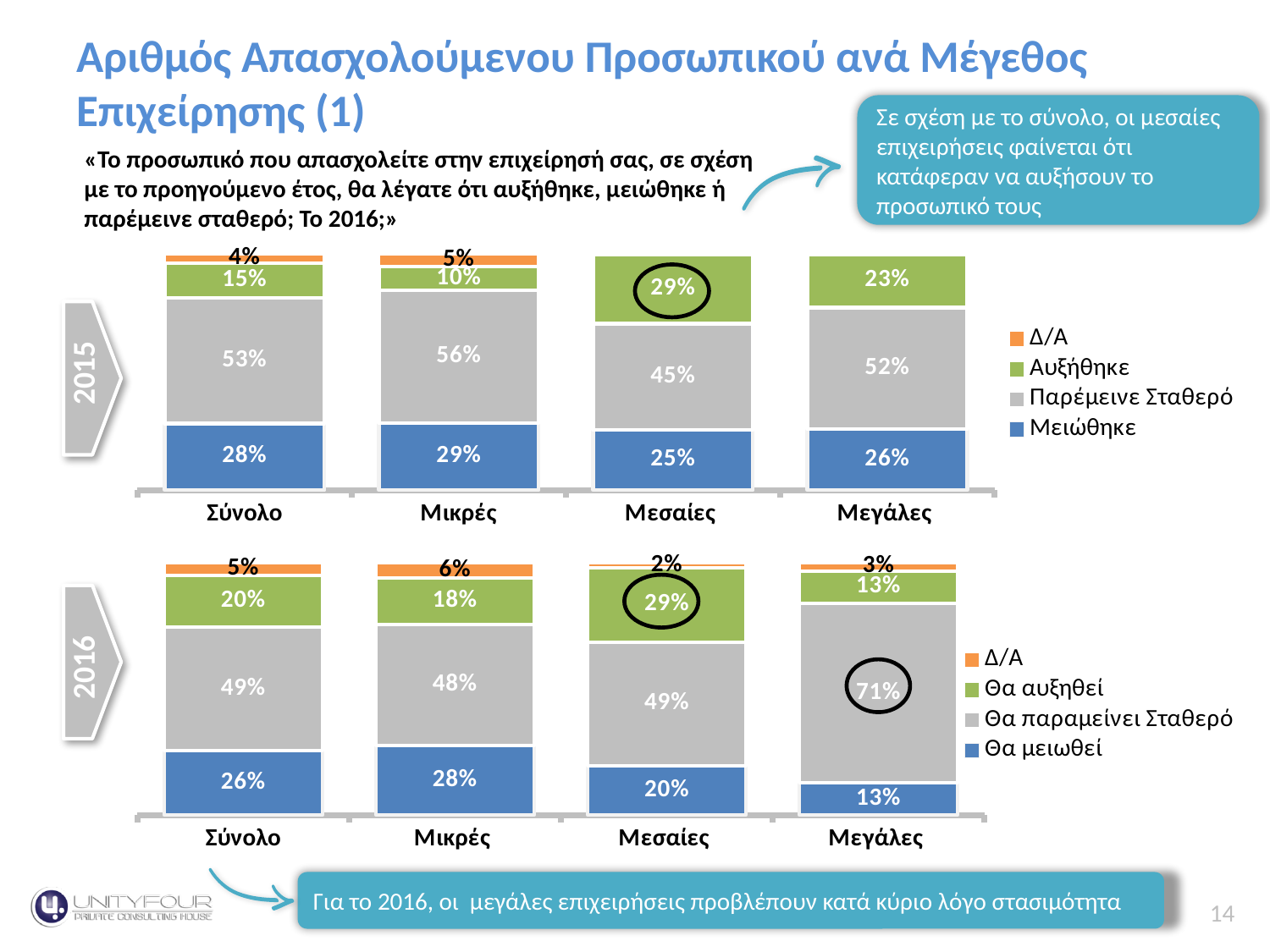
In the 2016 chart (bottom), which category has the lowest Θα αυξηθεί value? Μεγάλες In the 2015 chart (top), what is the difference between the Παρέμεινε Σταθερό values for Μικρές and Μεσαίες? 11% In the 2015 chart (top), what is the Παρέμεινε Σταθερό value for Μικρές? 56% What type of chart is the 2015 chart (top)? Stacked bar chart In the 2016 chart (bottom), what is the Θα παραμείνει Σταθερό value for Μεγάλες? 71% In the 2016 chart (bottom), which is larger: the Θα αυξηθεί value for Σύνολο or for Μικρές? Σύνολο How many series does the legend of the 2015 chart (top) list? 4 In the 2015 chart (top), what percentage of Μεσαίες businesses answered Αυξήθηκε? 29% In the 2016 chart (bottom), what is the total of the Δ/Α, Θα αυξηθεί, Θα παραμείνει Σταθερό and Θα μειωθεί values for Μεγάλες? 100% In the 2016 chart (bottom), what is the Θα μειωθεί value for Μεσαίες? 20% How many categories are shown on the x axis of the 2016 chart (bottom)? 4 In the 2015 chart (top), which category has the highest Μειώθηκε value? Μικρές